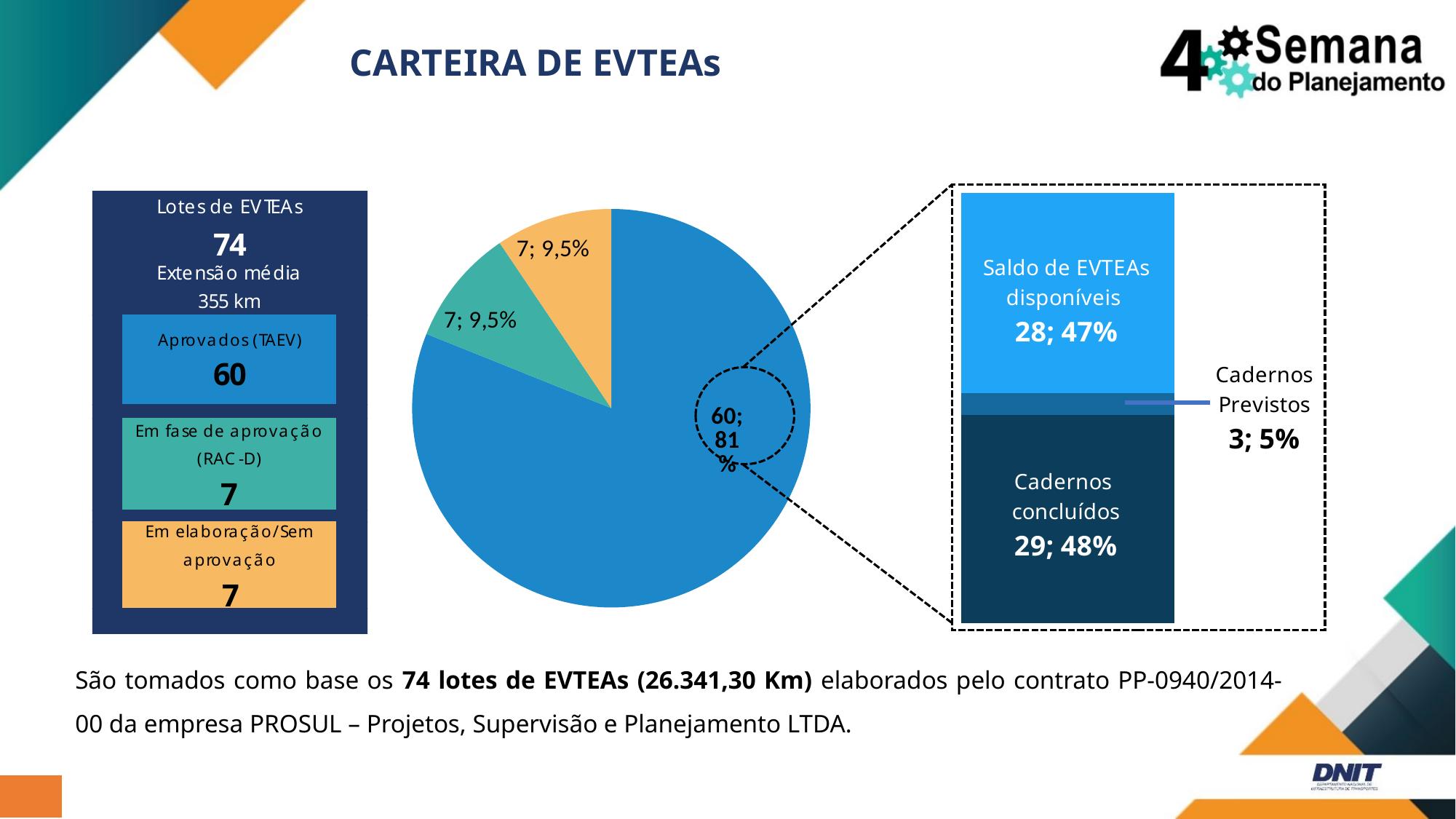
In the stacked bar on the right, what is the value for 'Saldo de EVTEAs disponíveis'? 28; 47% In the stacked bar on the right, what is the total of the three segments (28, 3 and 29)? 60 What is the data label on the largest slice of the pie chart? 60; 81% What kind of chart is the chart in the centre of the slide? pie chart In the stacked bar on the right, which is larger: 'Cadernos concluídos' or 'Saldo de EVTEAs disponíveis'? Cadernos concluídos In the pie chart, is the value of the blue slice greater or less than 50? greater In the pie chart, what share of the pie does the largest (blue) slice represent? 81% In the stacked bar on the right, which segment has the smallest value? Cadernos Previstos In the pie chart, what is the difference between the value of the blue slice and the value of the teal slice? 53 How many slices does the pie chart have? 3 In the pie chart, what share does the orange slice represent? 9,5% In the stacked bar on the right, what is the value for 'Cadernos concluídos'? 29; 48%